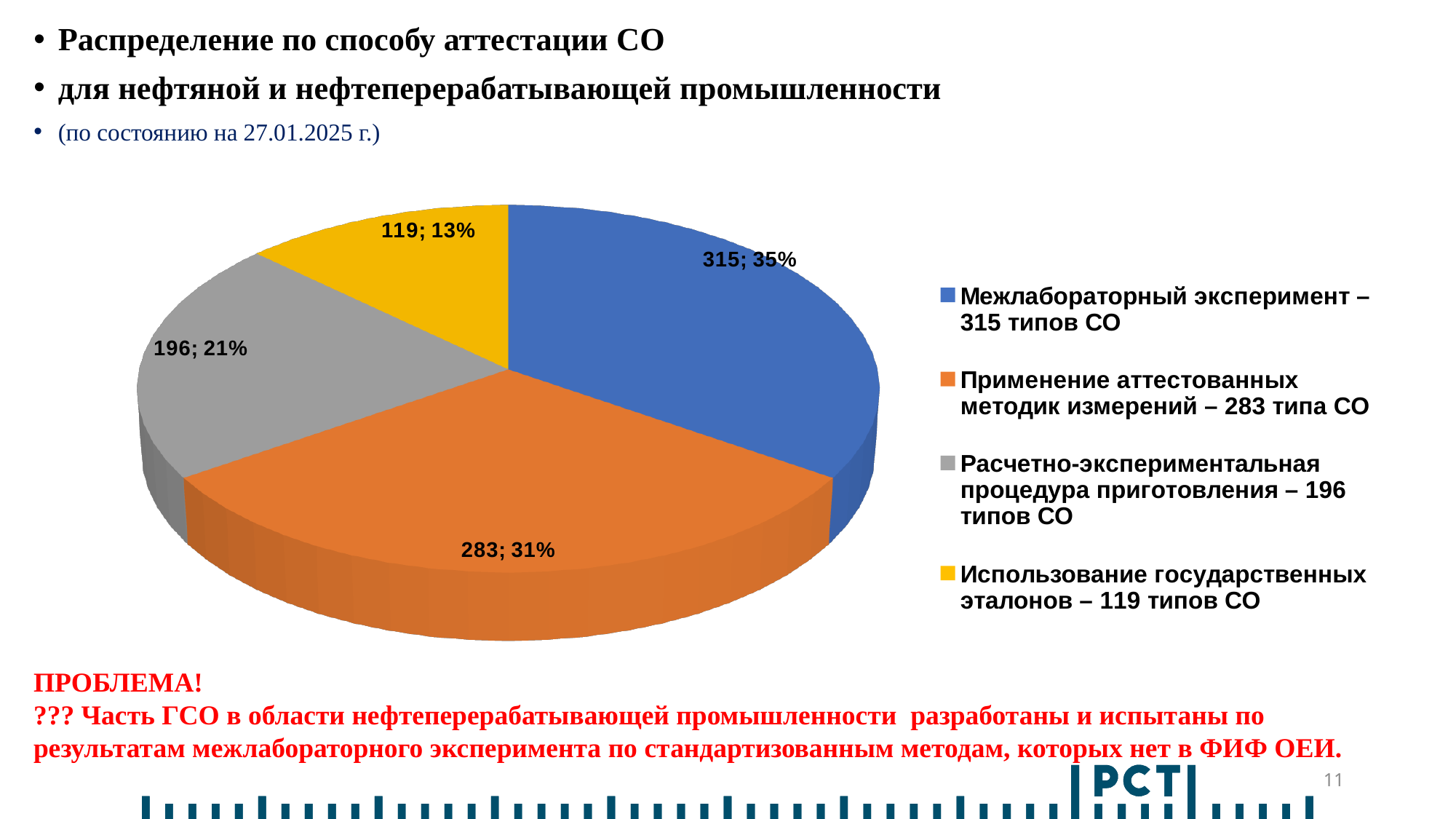
What share of the pie does Расчетно-экспериментальная процедура приготовления take? 21% What colour is the slice for Применение аттестованных методик измерений? Orange What is the value for Использование государственных эталонов? 119 Which category has the smallest slice? Использование государственных эталонов What is the difference between the values for Межлабораторный эксперимент and Применение аттестованных методик измерений? 32 Which category has the largest slice? Межлабораторный эксперимент How many entries does the legend list? 4 What is the value for Применение аттестованных методик измерений? 283 How many slices does the pie chart have? 4 Which is larger: the value for Расчетно-экспериментальная процедура приготовления or for Использование государственных эталонов? Расчетно-экспериментальная процедура приготовления What kind of chart is shown on the slide? Pie chart What is the value for Межлабораторный эксперимент? 315